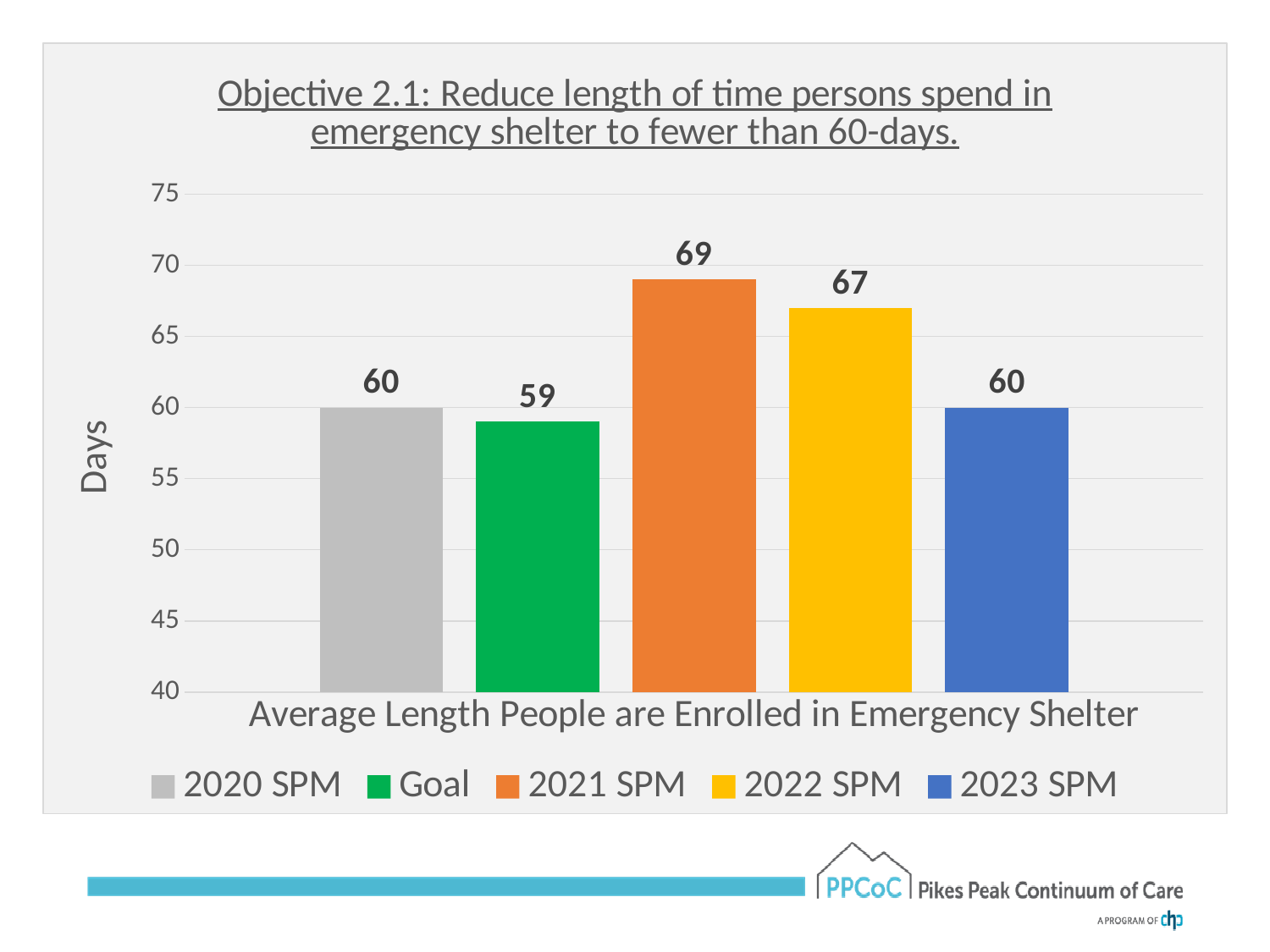
What kind of chart is shown on the slide? bar chart How many series does the legend list? 5 What is the value for 2022 SPM? 67 What is the value for Goal? 59 What is the value for 2023 SPM? 60 Which is larger, the value for 2022 SPM or the value for 2020 SPM? 2022 SPM What is the label on the vertical axis? Days What is the difference between the 2021 SPM value and the 2023 SPM value? 9 Which series has the highest value? 2021 SPM What is the value for 2021 SPM? 69 Which series has the lowest value? Goal Is the value for 2022 SPM greater or less than 65? greater